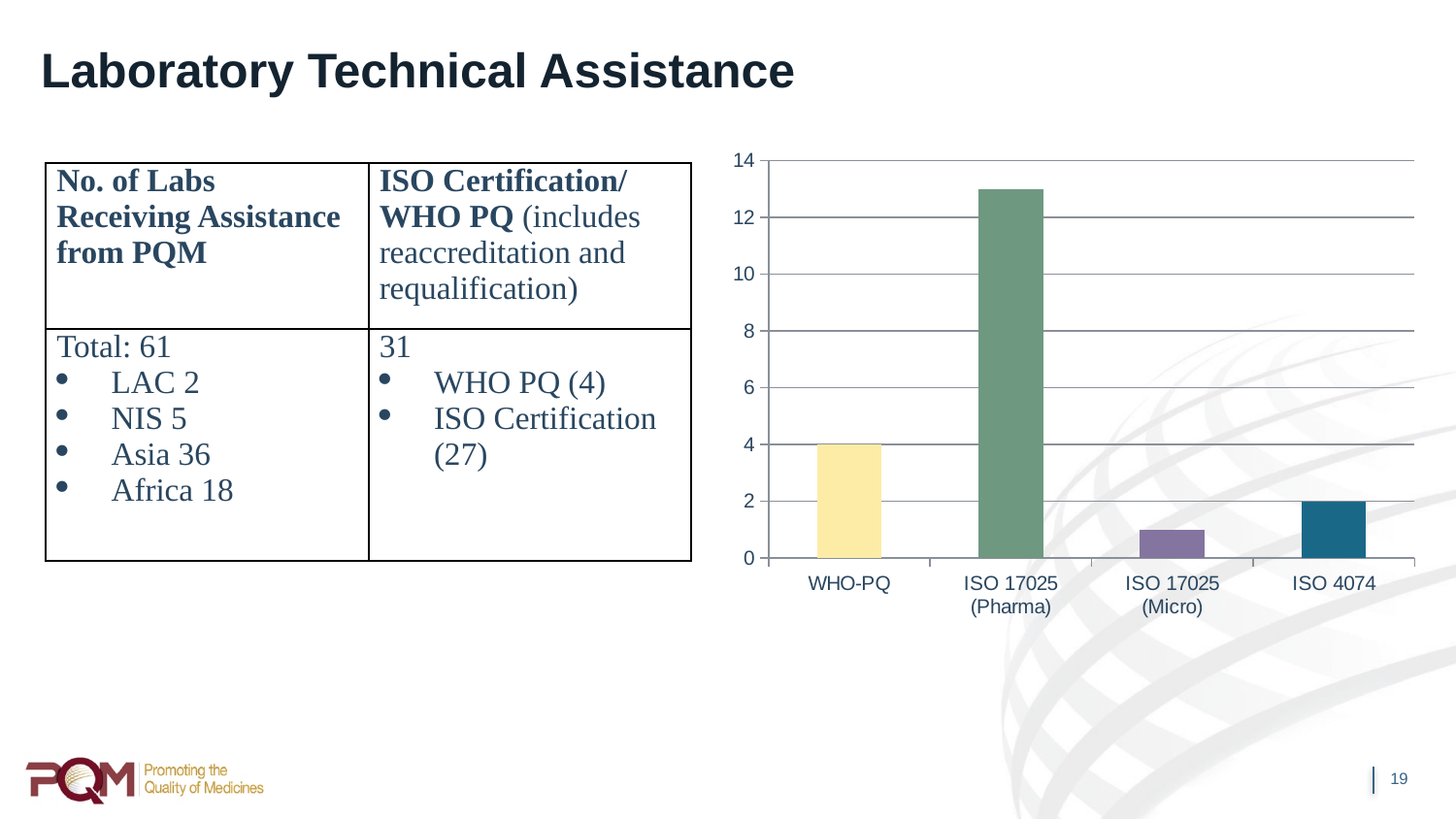
What is the value for ISO 4074 in the chart? 2 What is the difference between the value for WHO-PQ and the value for ISO 4074? 2 What kind of chart is shown on the slide? bar chart What is the highest value shown on the chart's vertical axis? 14 What is the label of the second category on the x axis of the chart? ISO 17025 (Pharma) Which is larger in the chart, the value for WHO-PQ or the value for ISO 4074? WHO-PQ Is the value for ISO 17025 (Micro) greater or less than 2? less Which category has the highest bar in the chart? ISO 17025 (Pharma) Which category has the lowest bar in the chart? ISO 17025 (Micro) What is the value for WHO-PQ in the chart? 4 How many categories are shown on the x axis of the chart? 4 Is the value for ISO 17025 (Pharma) greater or less than 12? greater